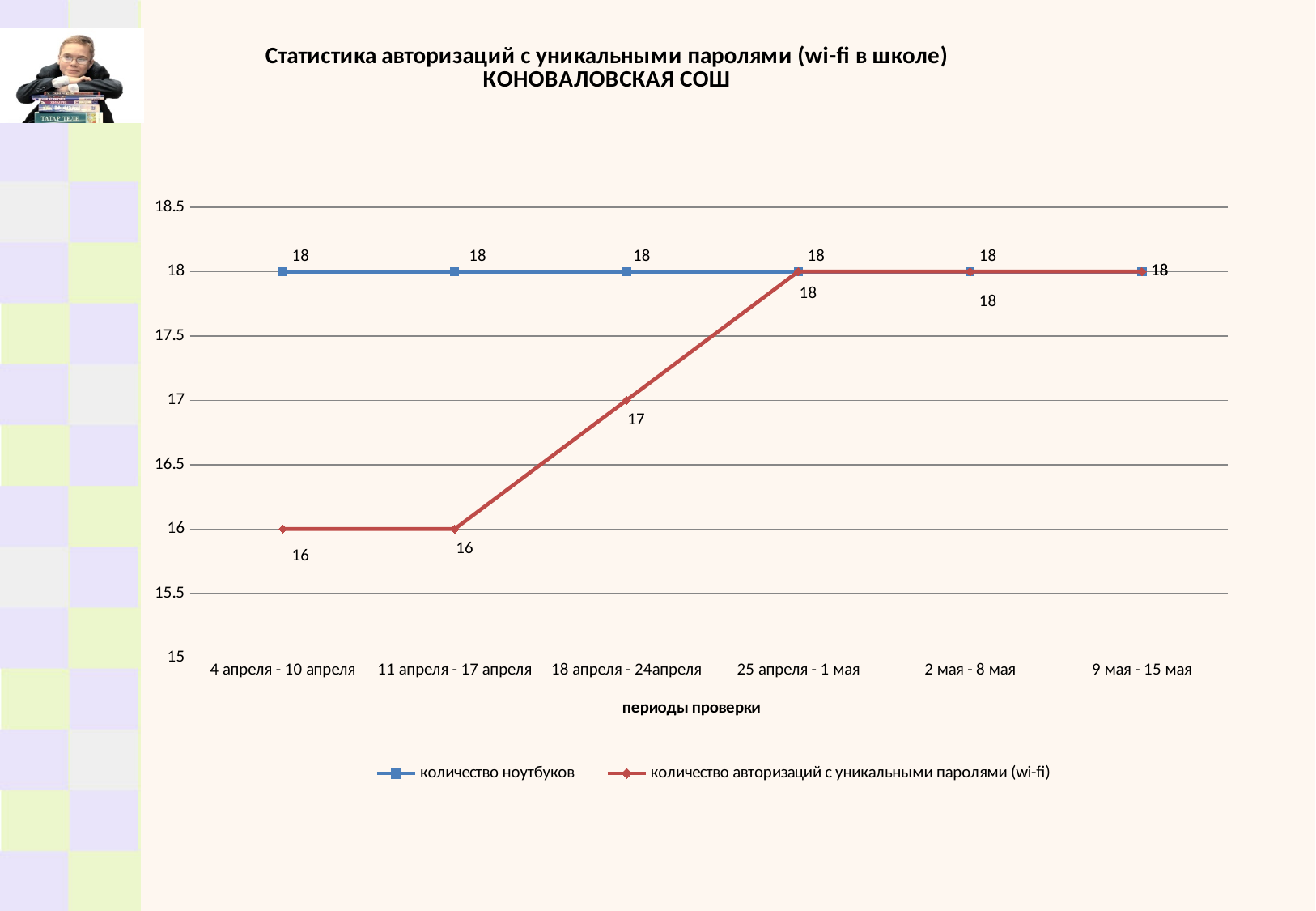
What is the value of "количество авторизаций с уникальными паролями (wi-fi)" for "25 апреля - 1 мая"? 18 Does the "количество авторизаций с уникальными паролями (wi-fi)" series rise or fall from "11 апреля - 17 апреля" to "25 апреля - 1 мая"? rise Which series has the larger value for "4 апреля - 10 апреля"? количество ноутбуков What is the x-axis title of the chart? периоды проверки How many series does the legend list? 2 What is the value of "количество авторизаций с уникальными паролями (wi-fi)" for "4 апреля - 10 апреля"? 16 What is the value of "количество авторизаций с уникальными паролями (wi-fi)" for "18 апреля - 24апреля"? 17 What kind of chart is shown on the slide? line chart How many check periods are shown on the x axis? 6 In which period does "количество авторизаций с уникальными паролями (wi-fi)" first reach 18? 25 апреля - 1 мая What is the difference between "количество ноутбуков" and "количество авторизаций с уникальными паролями (wi-fi)" for "11 апреля - 17 апреля"? 2 What is the value of "количество ноутбуков" for "2 мая - 8 мая"? 18